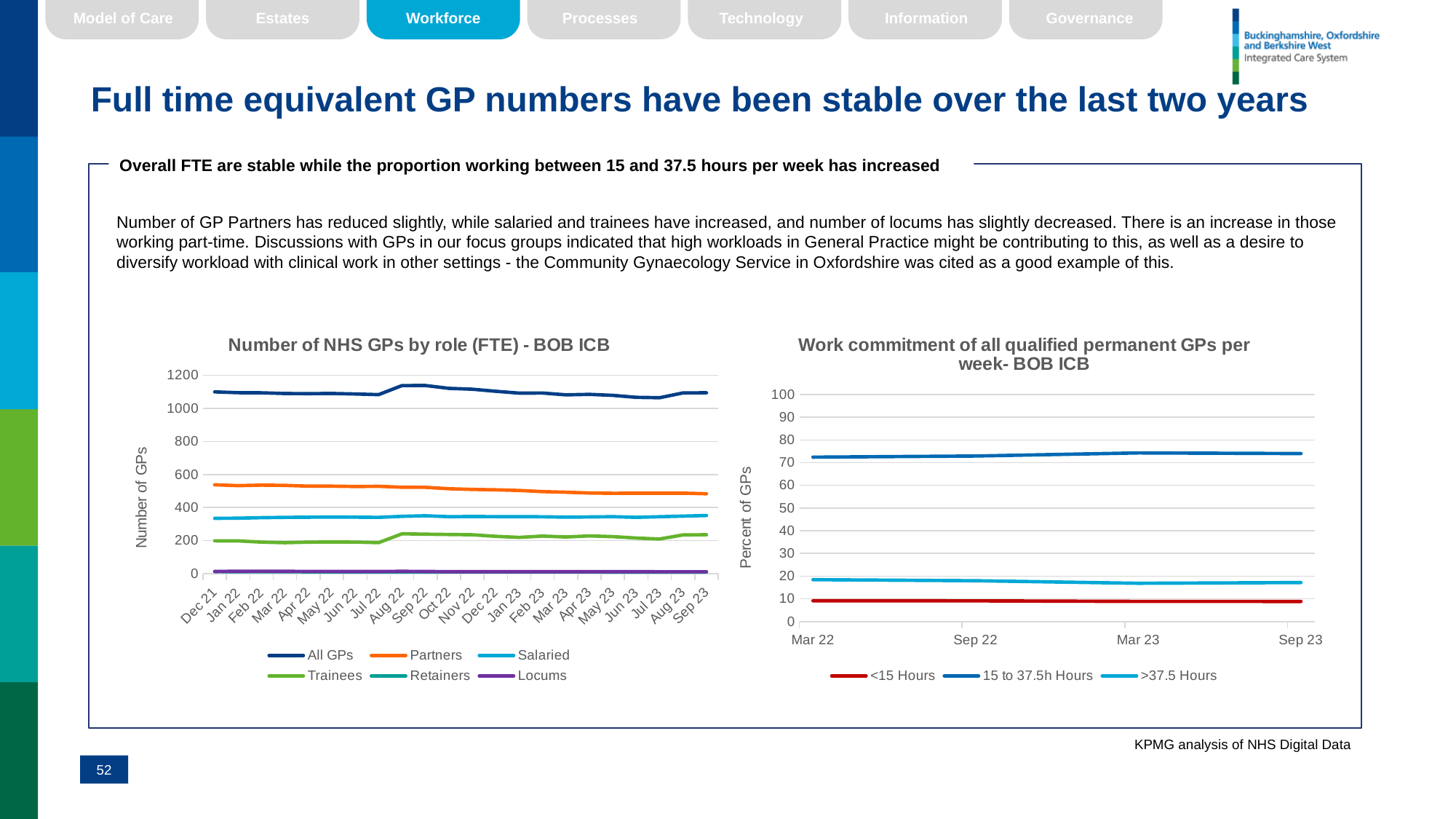
How many series does the legend of "Work commitment of all qualified permanent GPs per week- BOB ICB" list? 3 In "Number of NHS GPs by role (FTE) - BOB ICB", do the values for Partners rise or fall from Dec 21 to Sep 23? fall In "Work commitment of all qualified permanent GPs per week- BOB ICB", is the value for >37.5 Hours in Sep 23 greater or less than 20? less How many months are shown on the x axis of "Number of NHS GPs by role (FTE) - BOB ICB"? 22 In "Number of NHS GPs by role (FTE) - BOB ICB", is the value for Partners in Sep 23 greater or less than 600? less In "Number of NHS GPs by role (FTE) - BOB ICB", is the value for All GPs in Dec 21 greater or less than 1000? greater In "Work commitment of all qualified permanent GPs per week- BOB ICB", which series has the highest values? 15 to 37.5h Hours In "Number of NHS GPs by role (FTE) - BOB ICB", which is larger in Sep 23, Partners or Salaried? Partners How many series does the legend of "Number of NHS GPs by role (FTE) - BOB ICB" list? 6 What is the y-axis label of "Work commitment of all qualified permanent GPs per week- BOB ICB"? Percent of GPs What kind of chart is "Number of NHS GPs by role (FTE) - BOB ICB"? line chart